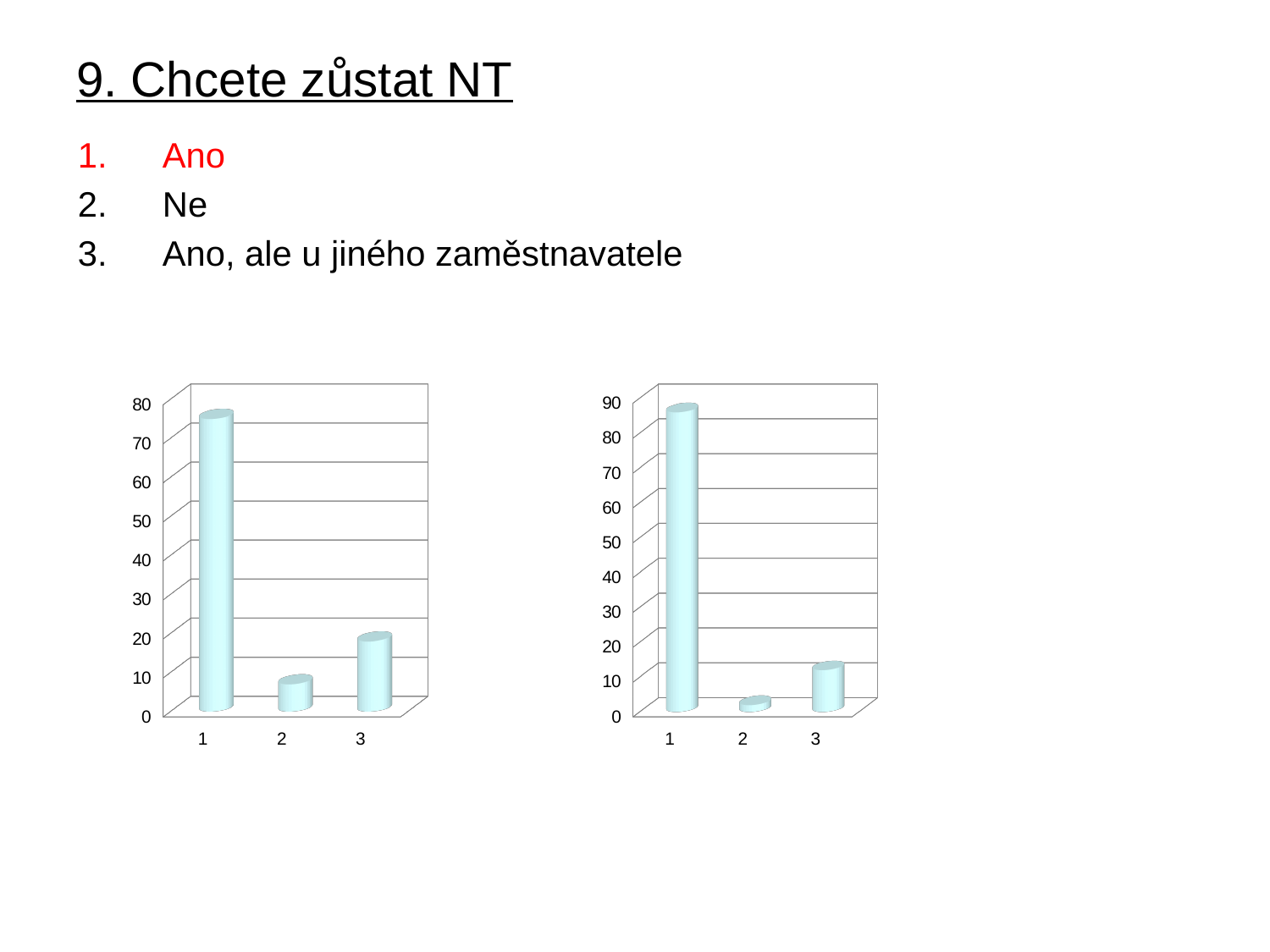
In the left chart, is the value for category 1 greater or less than 70? greater In the right chart, which is larger, the value for category 2 or category 3? 3 How many bars does the right chart show? 3 In the right chart, is the value for category 1 greater or less than 80? greater In the left chart, is the value for category 2 greater or less than 20? less In the left chart, which category has the highest bar? 1 In the right chart, which category has the lowest bar? 2 In the left chart, which category has the lowest bar? 2 In the right chart, which category has the highest bar? 1 How many bars does the left chart show? 3 What type of chart is the left chart on the slide? bar chart